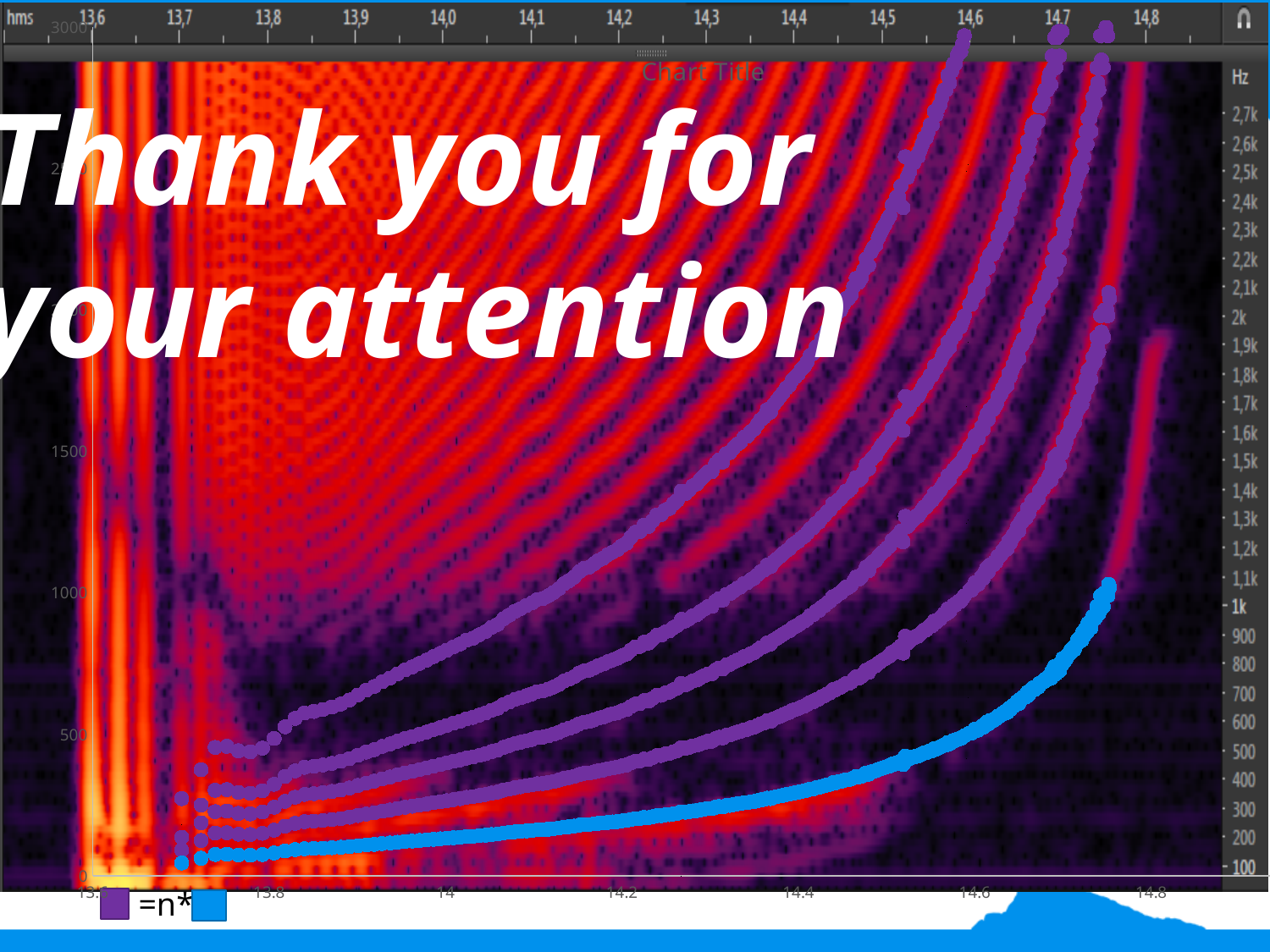
How many separate curves are plotted on the chart? 5 What is the highest tick label on the chart's y axis? 3000 Is the value of the blue series at x = 14.4 greater or less than 1000? less Is the value of the topmost purple series at x = 14.4 greater or less than 1500? greater What kind of chart is overlaid on the spectrogram image? scatter chart How many colours of data series does the legend show? 2 Is the value of the blue series at x = 14 greater or less than 500? less What is the title shown on the chart? Chart Title Do the plotted values rise or fall as the x axis increases from 13.8 to 14.8? rise Which colour series lies lowest on the chart? blue